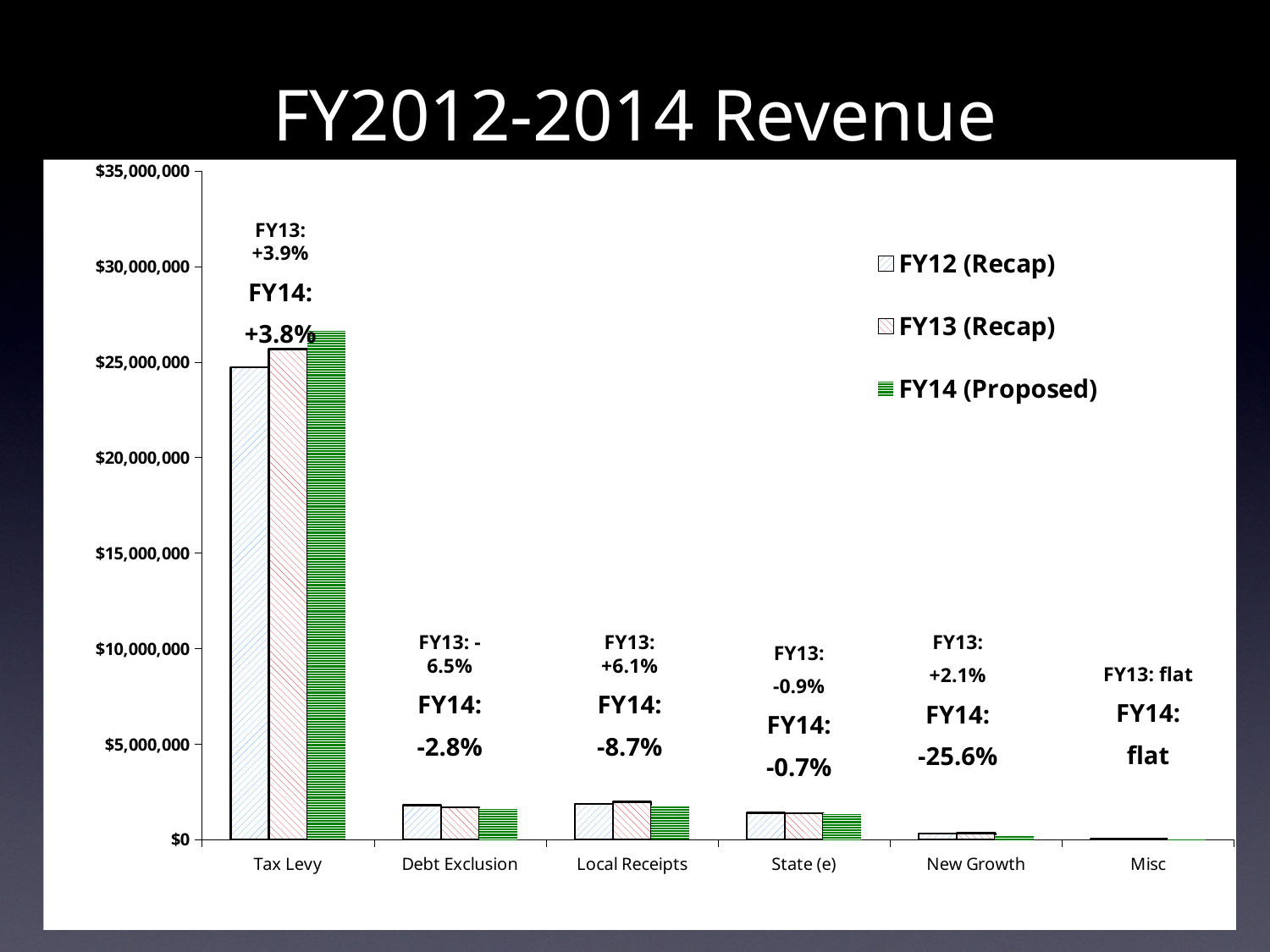
How many revenue categories are shown on the x axis? 6 What kind of chart is shown on the slide? bar chart Is the FY14 (Proposed) value for Tax Levy greater or less than $25,000,000? greater What FY14 percentage change is annotated for New Growth? -25.6% Which is larger, the FY13 (Recap) value for Local Receipts or the FY13 (Recap) value for New Growth? Local Receipts Which category has the lowest revenue? Misc What FY13 percentage change is annotated for Local Receipts? +6.1% Which category has the highest revenue? Tax Levy Do the Tax Levy bars rise or fall from FY12 to FY14? rise What is the title of the chart? FY2012-2014 Revenue How many series does the legend list? 3 Is the FY12 (Recap) value for Debt Exclusion greater or less than $5,000,000? less